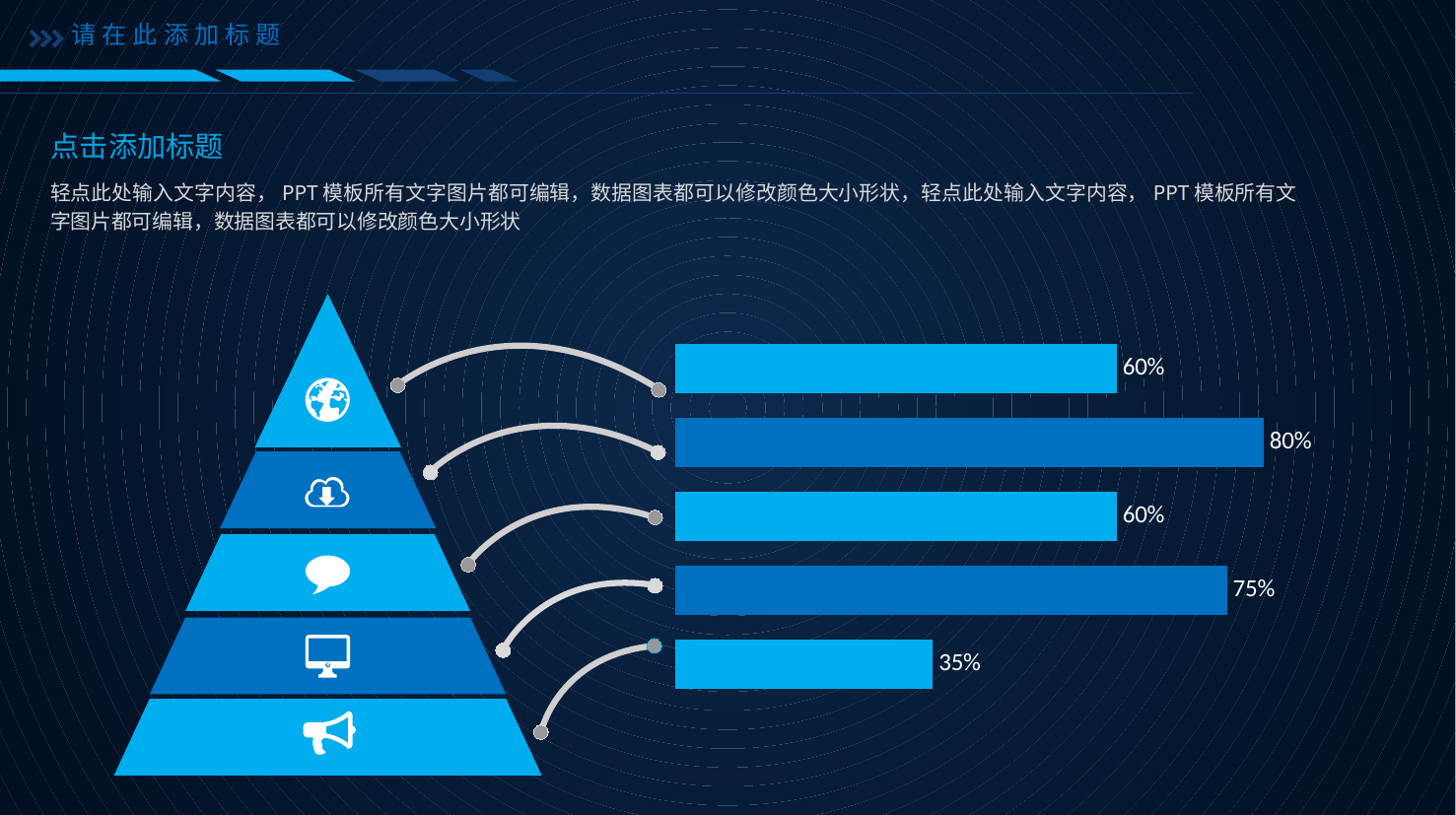
What is the value of the bottom bar in the bar chart? 35% Which is larger in the bar chart: the second bar from the top or the fourth bar from the top? the second bar from the top (80%) What is the value of the fourth bar from the top in the bar chart? 75% What is the value of the second bar from the top in the bar chart? 80% How many bars are in the bar chart? 5 What is the difference between the highest and lowest bar values in the bar chart? 45% Which bar has the highest value in the bar chart? the second bar from the top (80%) What is the value of the top bar in the bar chart? 60% What kind of chart is shown on the right side of the slide? bar chart Which bar has the lowest value in the bar chart? the bottom bar (35%) How many levels does the pyramid on the left of the slide have? 5 What is the difference between the fourth bar (75%) and the bottom bar (35%) in the bar chart? 40%